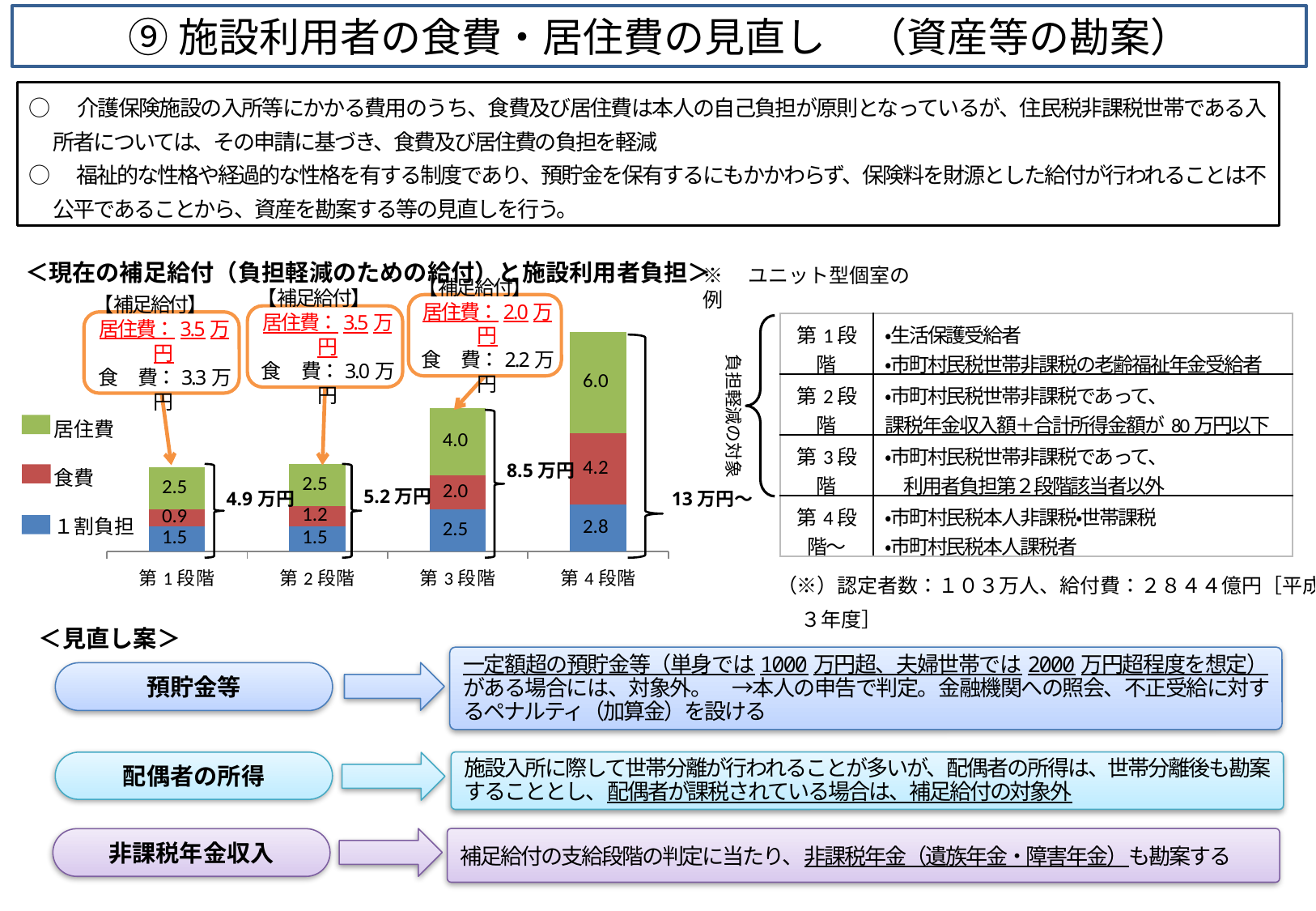
What kind of chart is shown on the slide? stacked bar chart What is the total labelled for the stacked bar of 第3段階? 8.5万円 What is the value of 居住費 for 第3段階? 4.0 What is the difference between the 食費 values for 第4段階 and 第3段階? 2.2 What is the value of 食費 for 第2段階? 1.2 What is the value of 1割負担 for 第4段階? 2.8 How many series does the chart legend list? 3 Which category has the lowest 食費 value? 第1段階 Which is larger, the 1割負担 value for 第3段階 or for 第2段階? 第3段階 Do the 居住費 values rise or fall from 第1段階 to 第4段階? rise Which category has the highest 居住費 value? 第4段階 How many categories (段階) are shown on the x axis of the chart? 4